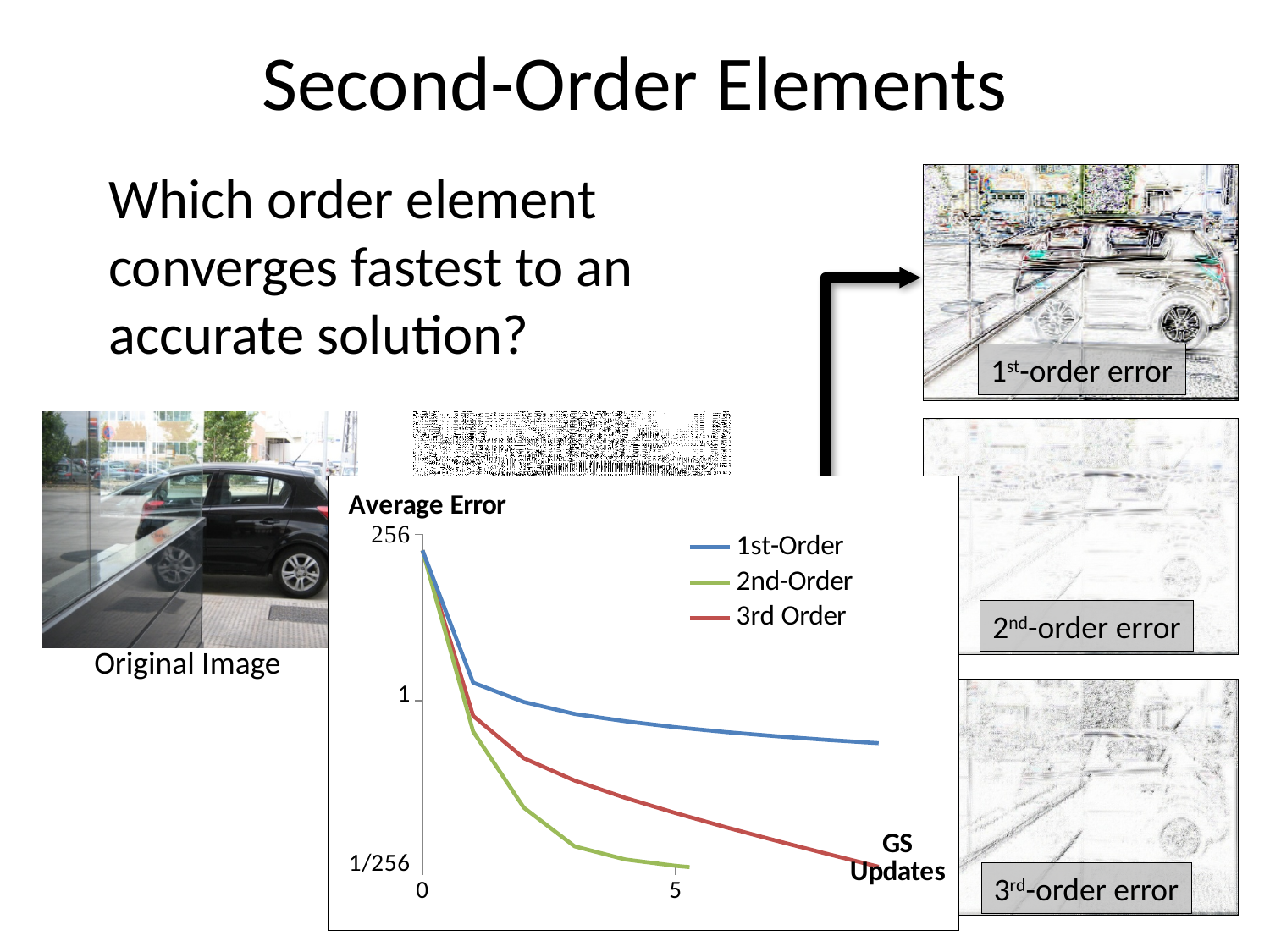
At 5 GS Updates, which series has the higher average error, 1st-Order or 3rd Order? 1st-Order What is the title of the chart? Average Error At 5 GS Updates, which series has the lower average error, 2nd-Order or 3rd Order? 2nd-Order Is the average error for the 3rd Order series at 5 GS Updates greater or less than 1? less Which series has the highest average error at 5 GS Updates? 1st-Order Does the average error for the 1st-Order series rise or fall as GS Updates increase? fall Is the average error for the 2nd-Order series at 5 GS Updates greater or less than 1? less What is the label of the x axis of the chart? GS Updates How many series does the chart's legend list? 3 Which series has the lowest average error at 5 GS Updates? 2nd-Order Does the average error for the 2nd-Order series rise or fall as GS Updates increase? fall What kind of chart is shown on the slide? line chart